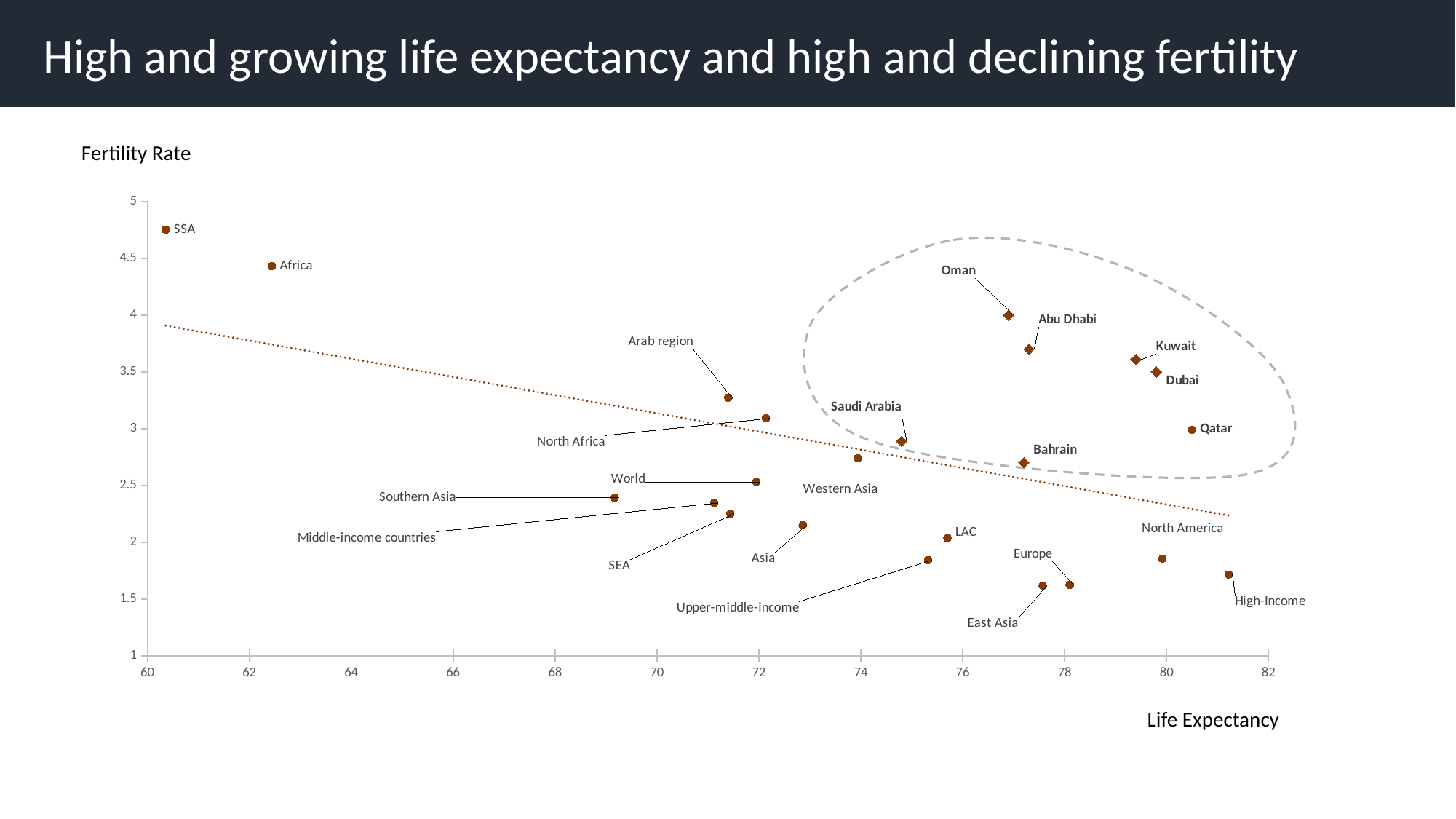
What kind of chart is shown on the slide? Scatter chart Which point has the highest life expectancy? High-Income Is the fertility rate for SSA greater or less than 4.5? greater Which point has the lowest life expectancy? SSA Is the life expectancy for Oman greater or less than 76? greater According to the dotted trend line, does the fertility rate rise or fall as life expectancy increases? Fall Which point has the highest fertility rate? SSA Which has the higher life expectancy, Qatar or Saudi Arabia? Qatar How many labelled points are enclosed by the dashed ellipse? 7 Which has the higher fertility rate, Oman or Bahrain? Oman Is the life expectancy for Qatar greater or less than 80? greater